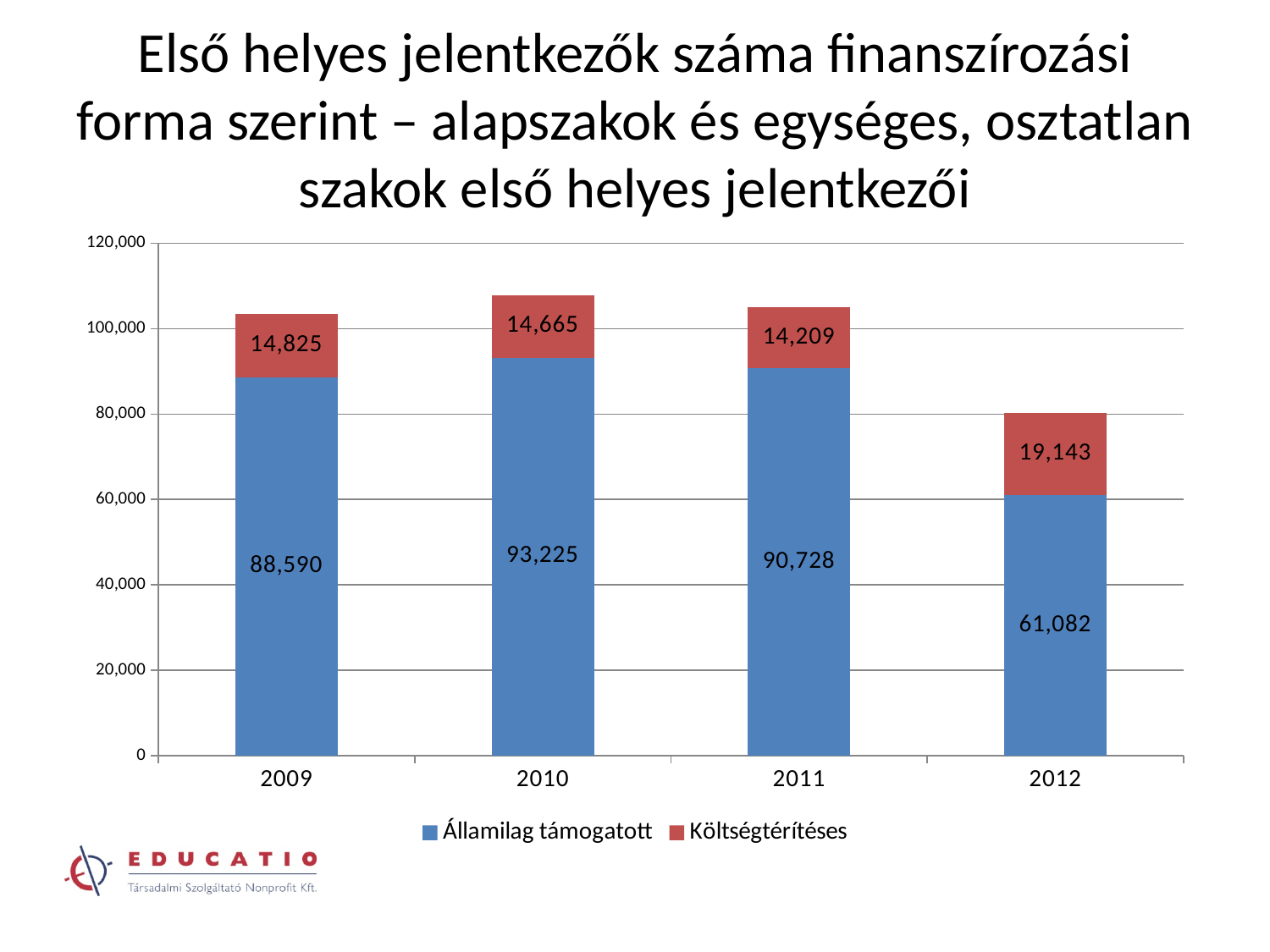
How many series does the legend list? 2 How many years are shown on the x axis? 4 Which year has the lowest value for Költségtérítéses? 2011 What is the value for Költségtérítéses in 2012? 19,143 What is the total of the stacked bar for 2012? 80,225 Which year has the highest value for Államilag támogatott? 2010 What is the value for Államilag támogatott in 2012? 61,082 What is the value for Államilag támogatott in 2010? 93,225 Which is larger, the Költségtérítéses value for 2009 or for 2012? 2012 What is the total of the stacked bar for 2009? 103,415 What kind of chart is shown on the slide? Stacked bar chart What is the difference between the Államilag támogatott values for 2010 and 2012? 32,143